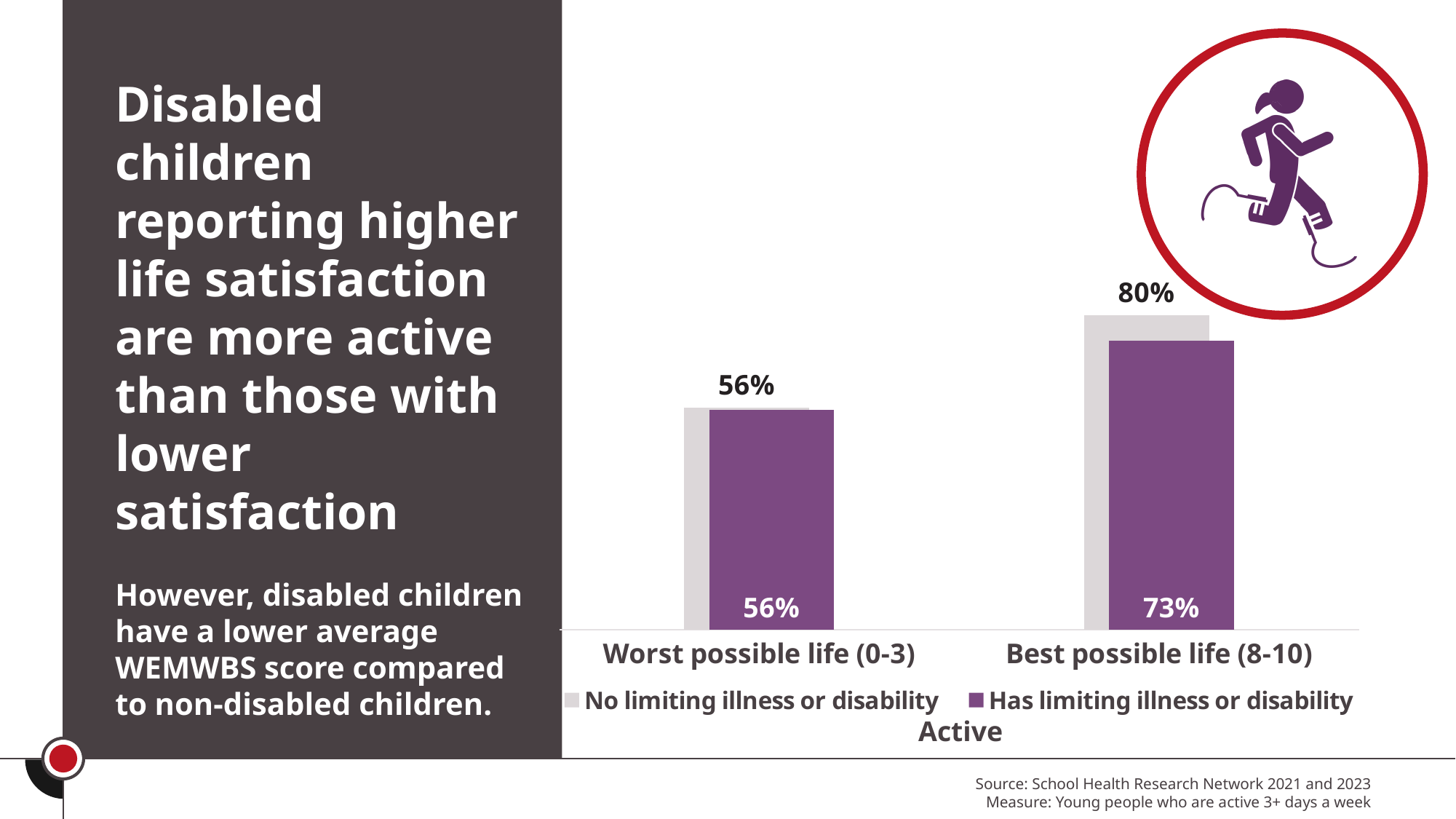
Which colour represents the 'Has limiting illness or disability' series in the chart? purple In the 'Best possible life (8-10)' category, which series has the larger value? No limiting illness or disability What kind of chart is shown on the slide? bar chart What is the value for 'Has limiting illness or disability' in the 'Worst possible life (0-3)' category? 56% For 'Has limiting illness or disability', what is the difference between the 'Best possible life (8-10)' and 'Worst possible life (0-3)' values? 17% Which category has the highest value for 'Has limiting illness or disability'? Best possible life (8-10) What is the difference between the 'No limiting illness or disability' and 'Has limiting illness or disability' values in the 'Best possible life (8-10)' category? 7% What is the value for 'No limiting illness or disability' in the 'Best possible life (8-10)' category? 80% What is the value for 'Has limiting illness or disability' in the 'Best possible life (8-10)' category? 73% How many series does the chart legend list? 2 How many categories are shown on the x axis of the chart? 2 What is the value for 'No limiting illness or disability' in the 'Worst possible life (0-3)' category? 56%